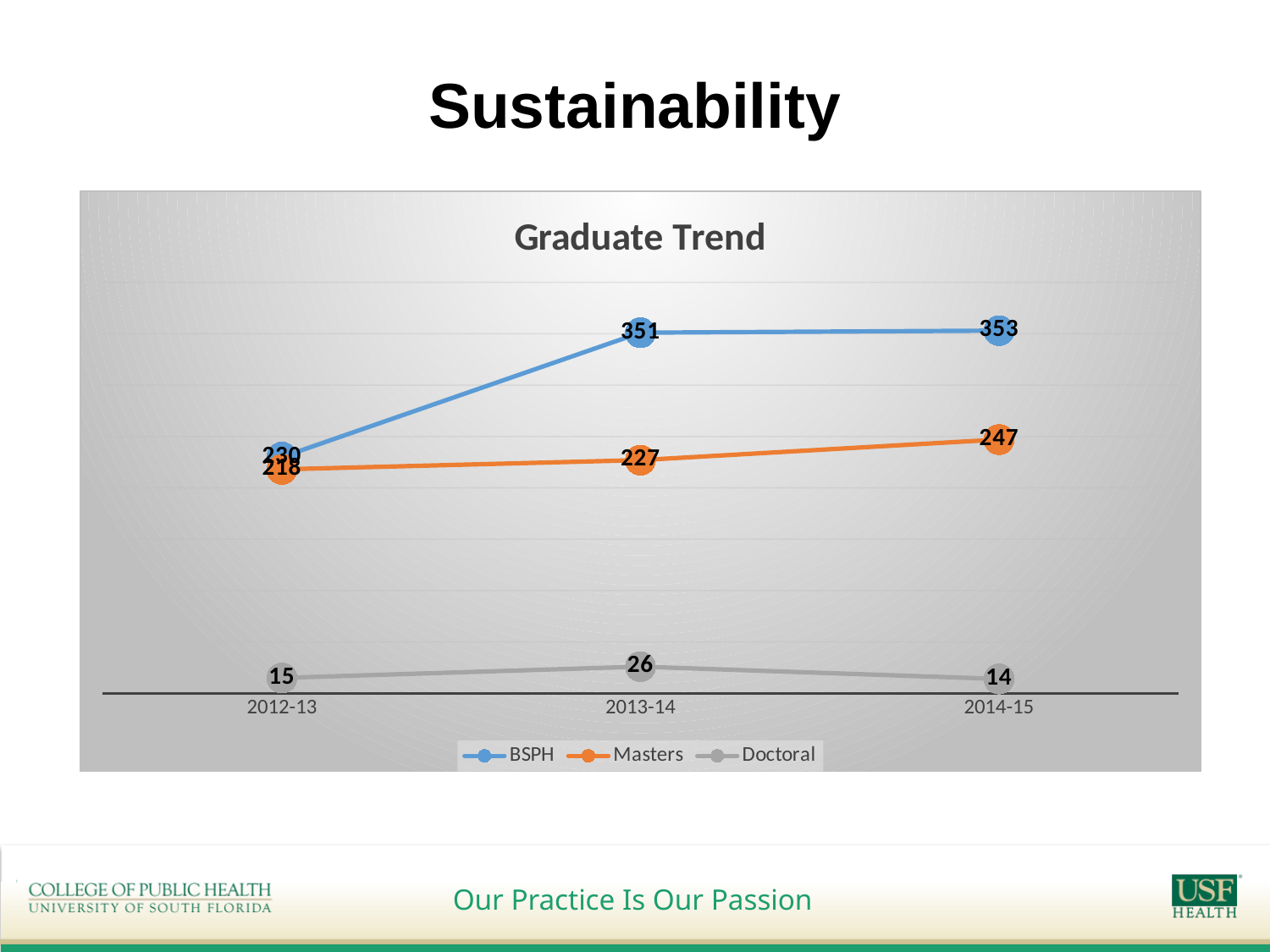
How many academic years are shown on the x axis of the Graduate Trend chart? 3 What is the difference between the BSPH and Masters values in 2014-15? 106 How many series does the legend of the Graduate Trend chart list? 3 What is the title of the chart? Graduate Trend What is the Doctoral value for 2014-15? 14 What is the Doctoral value for 2013-14? 26 In which year is the Doctoral series highest? 2013-14 What is the Masters value for 2014-15? 247 What kind of chart is shown on the slide? line chart Does the Masters series rise or fall from 2012-13 to 2014-15? rise Which is larger for Masters: the 2013-14 value or the 2014-15 value? 2014-15 What is the BSPH value for 2013-14? 351